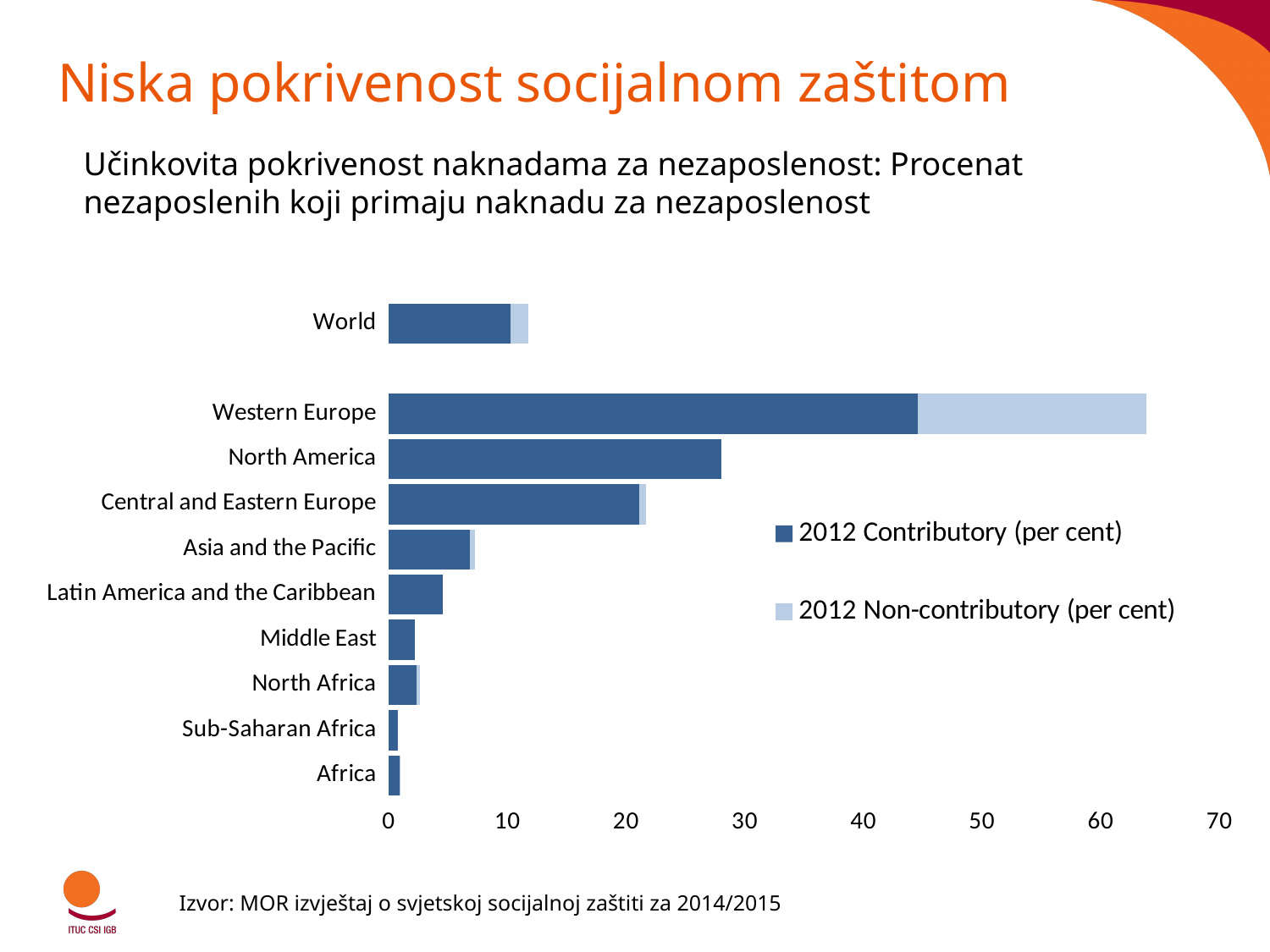
How many series does the legend list? 2 Which has a larger 2012 Contributory value, North America or Central and Eastern Europe? North America What is the maximum value shown on the horizontal axis? 70 Is the total value for Western Europe greater or less than 60? greater Is the 2012 Contributory value for Central and Eastern Europe greater or less than 30? less Is the 2012 Contributory value for Asia and the Pacific greater or less than 10? less Which has a larger total bar, Western Europe or North America? Western Europe What kind of chart is shown on the slide? bar chart Which region has the highest total bar on the chart? Western Europe How many categories (regions, including World) are plotted on the chart? 10 What are the two series named in the legend? 2012 Contributory (per cent) and 2012 Non-contributory (per cent)